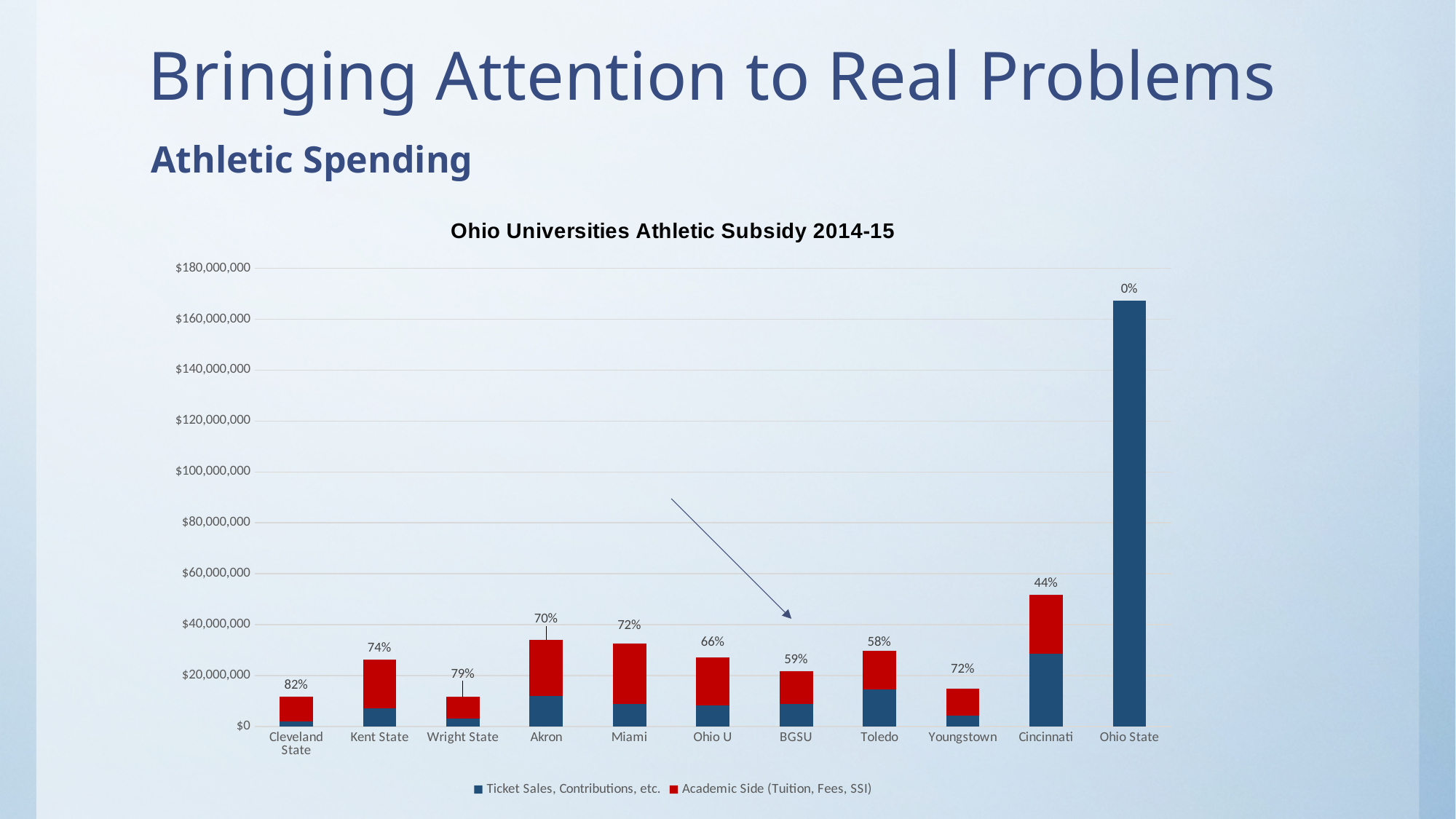
Which has the taller total bar, Kent State or Wright State? Kent State What is the title of the chart? Ohio Universities Athletic Subsidy 2014-15 What kind of chart is shown on the slide? Stacked bar chart Is the total bar for Cincinnati greater or less than $40,000,000? greater How many series does the legend list? 2 What percentage label is shown above the Cincinnati bar? 44% How many universities are shown on the x axis? 11 What percentage label is shown above the Cleveland State bar? 82% Which university has the highest percentage label above its bar? Cleveland State What percentage label is shown above the Ohio State bar? 0% Is the total bar for Ohio State greater or less than $160,000,000? greater Which university has the tallest bar? Ohio State